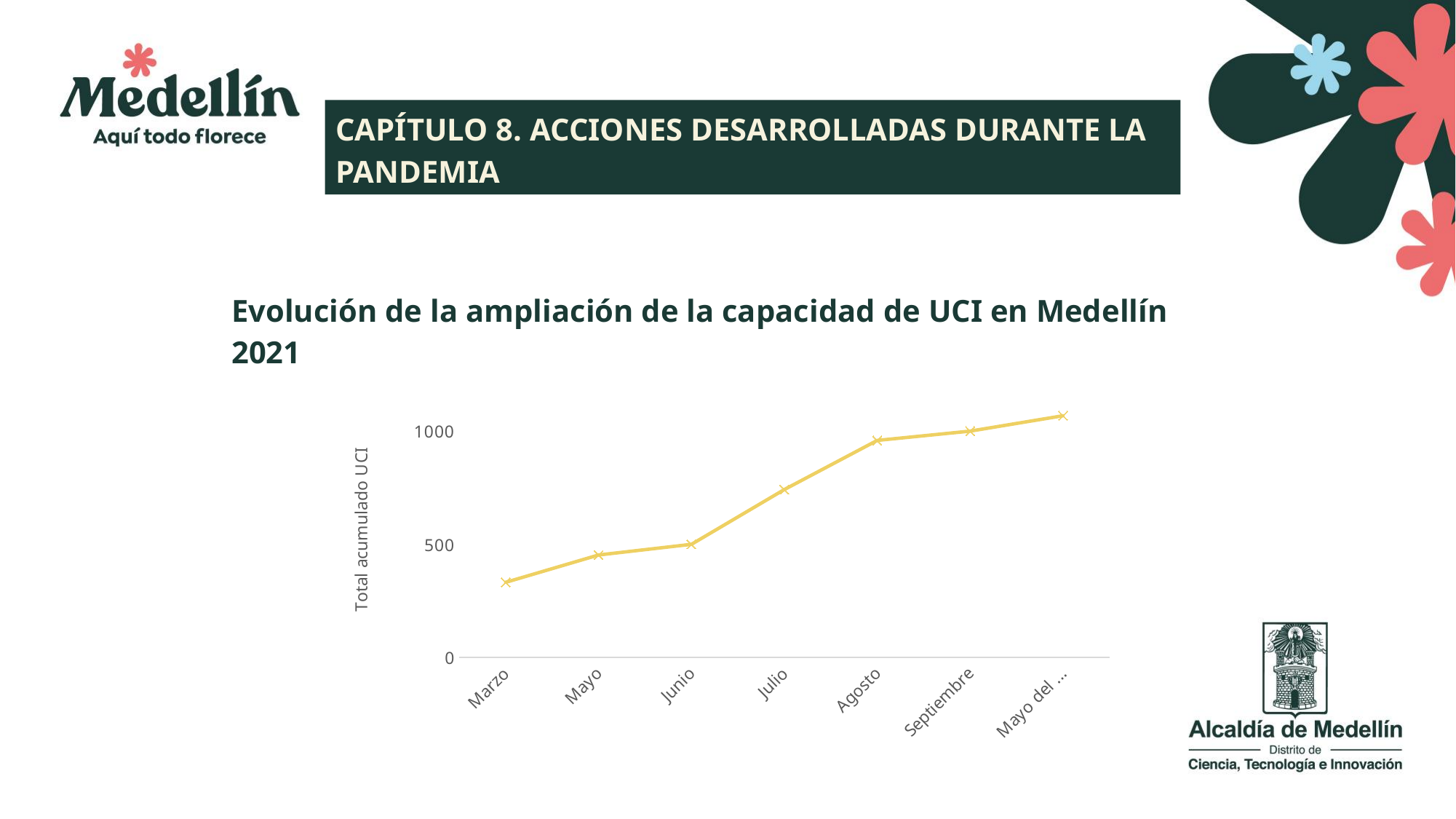
What is the label of the vertical axis? Total acumulado UCI What kind of chart is shown on the slide? line chart Which month has the lowest value? Marzo What is the title of the chart? Evolución de la ampliación de la capacidad de UCI en Medellín 2021 Is the value for Julio greater or less than 1000? less Which is larger, the value for Julio or the value for Marzo? Julio Which is larger, the value for Junio or the value for Agosto? Agosto Is the value for Agosto greater or less than 500? greater How many data points are plotted on the line? 7 Do the values rise or fall from Marzo to the last point on the x axis? rise Is the value for Marzo greater or less than 500? less